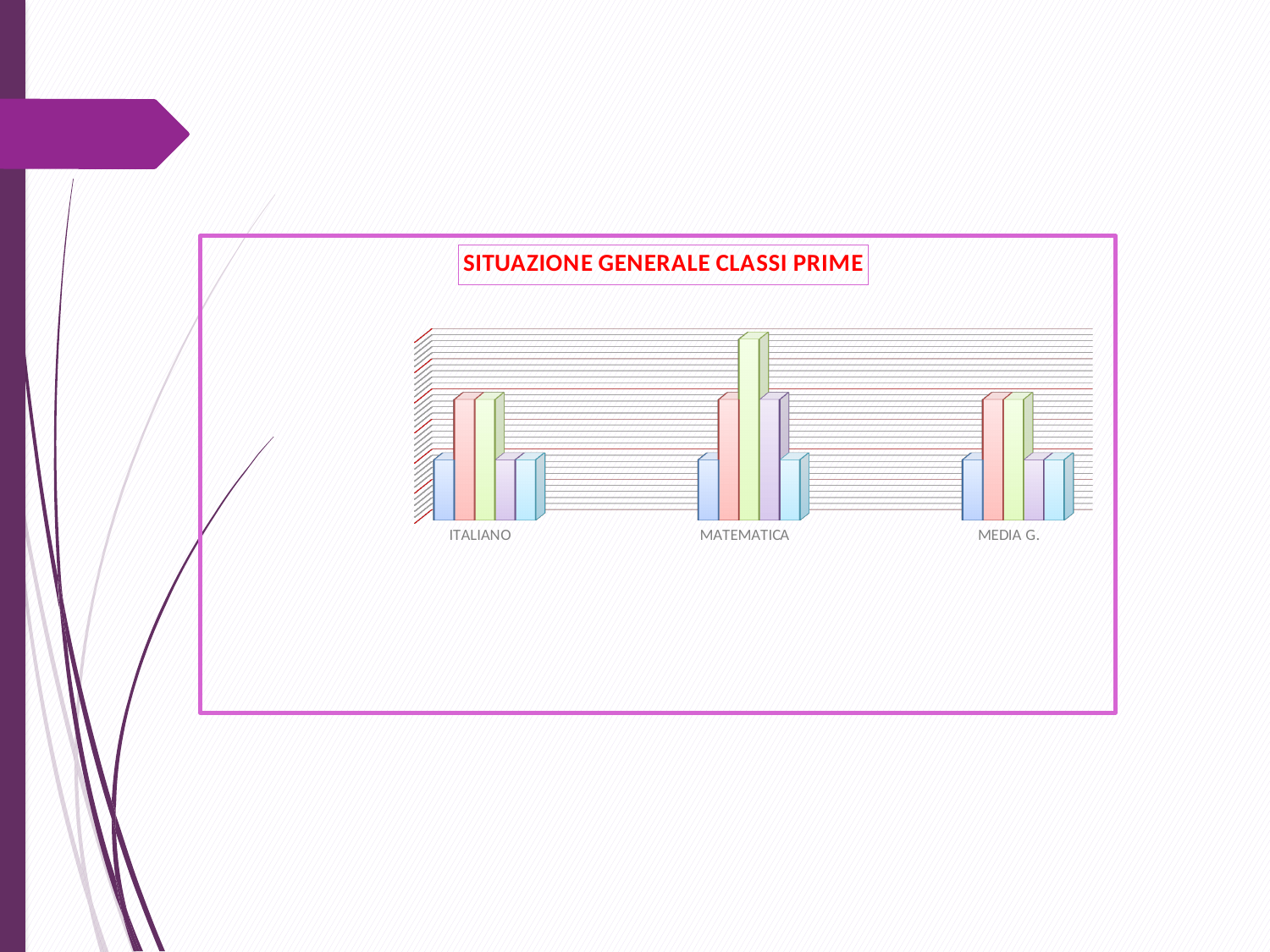
What kind of chart is shown on the slide? bar chart What are the category labels on the x axis, from left to right? ITALIANO, MATEMATICA, MEDIA G. In the MEDIA G. category, is the purple bar taller or shorter than the red bar? shorter How many categories are shown on the x axis of the chart? 3 Which category contains the tallest bar on the chart? MATEMATICA In the MATEMATICA category, which bar is the tallest: the red bar or the green bar? the green bar How many bars are plotted for each category? 5 How many bars are plotted in total on the chart? 15 In the ITALIANO category, which bar is taller: the blue bar or the red bar? the red bar What is the title of the chart? SITUAZIONE GENERALE CLASSI PRIME